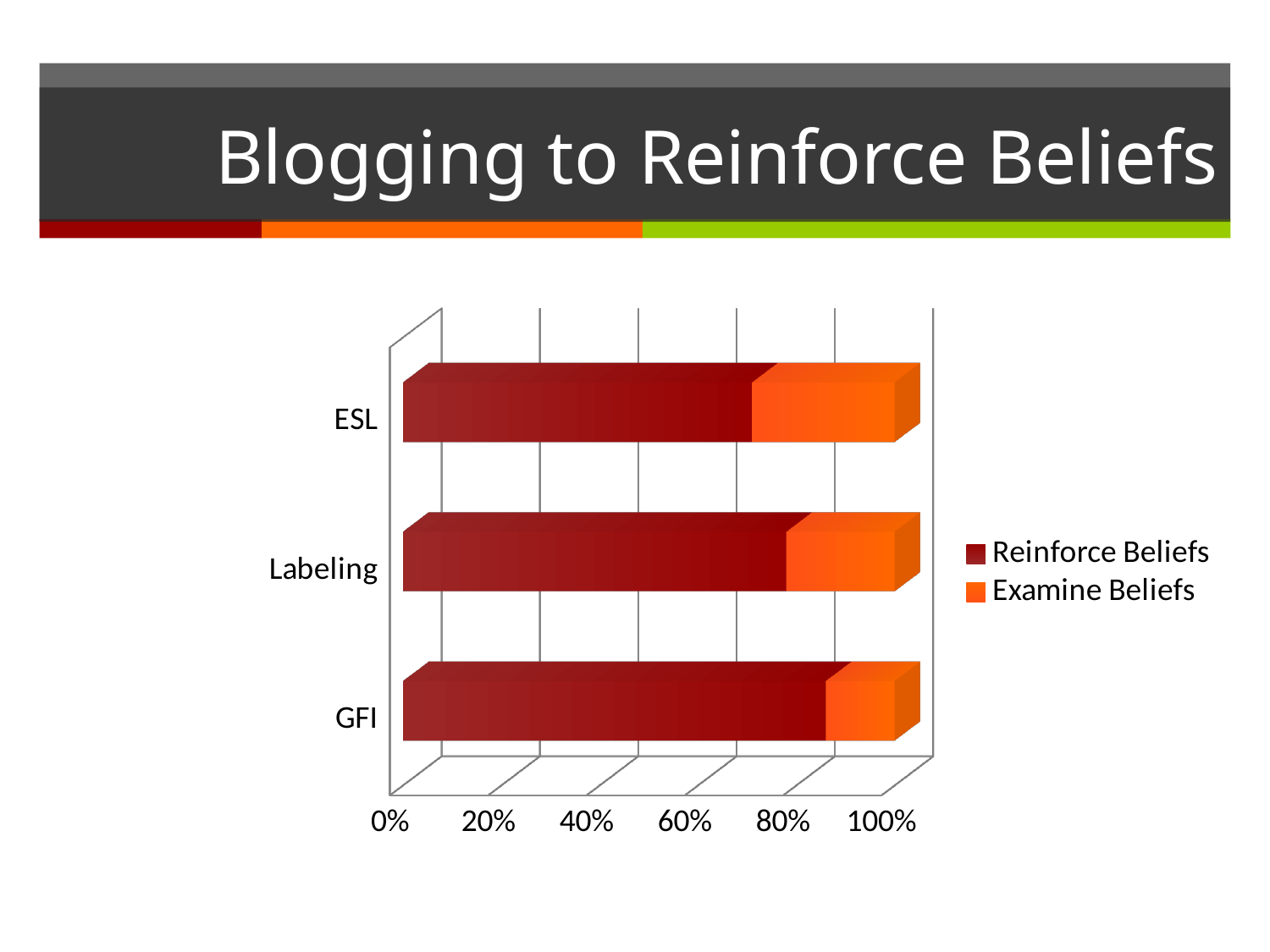
Is the Reinforce Beliefs share for ESL greater or less than 80%? less Which category has the largest Reinforce Beliefs share? GFI Which series is shown in orange in the legend? Examine Beliefs Is the Reinforce Beliefs share for ESL greater or less than 60%? greater How many series does the legend list? 2 How many categories are shown on the chart? 3 Which category has the largest Examine Beliefs share? ESL What kind of chart is shown on the slide? Stacked bar chart Is the Reinforce Beliefs share for GFI greater or less than 60%? greater Which is larger, the Reinforce Beliefs share for GFI or for ESL? GFI Which category has the smallest Reinforce Beliefs share? ESL What is the title of the slide containing the chart? Blogging to Reinforce Beliefs